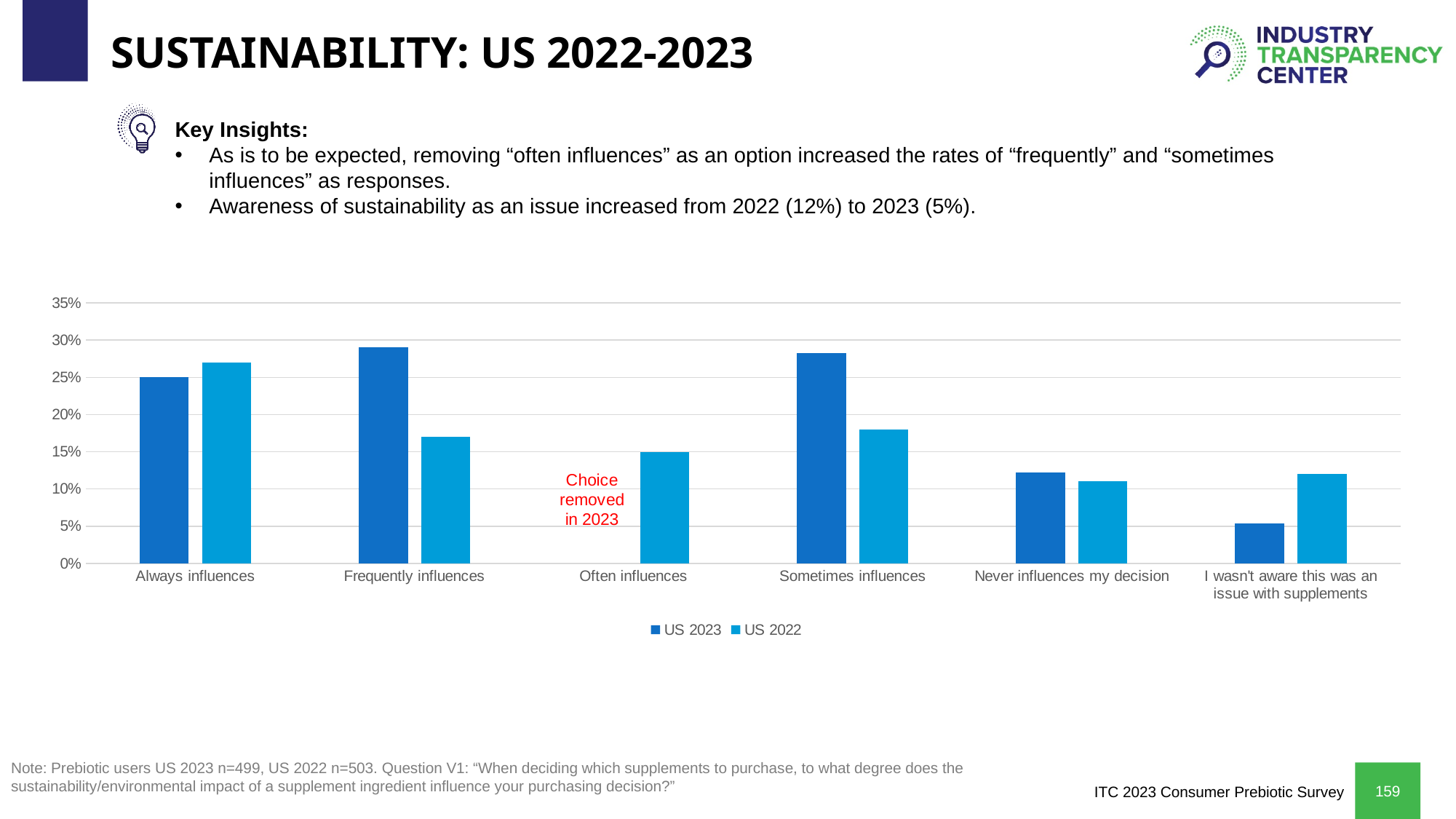
Is the US 2022 value for "Frequently influences" greater or less than 20%? less Is the US 2023 value for "Sometimes influences" greater or less than 25%? greater What kind of chart is shown on the slide? Bar chart For "Frequently influences", which series has the larger value, US 2023 or US 2022? US 2023 How many series does the chart legend list? 2 For "Sometimes influences", which series has the larger value, US 2023 or US 2022? US 2023 Which category has no US 2023 bar in the chart? Often influences What does the red text in the chart say? Choice removed in 2023 For "Always influences", which series has the larger value, US 2023 or US 2022? US 2022 How many response categories are shown along the x axis of the chart? 6 Which category has the highest US 2022 value? Always influences Which category has the lowest US 2023 value? I wasn't aware this was an issue with supplements